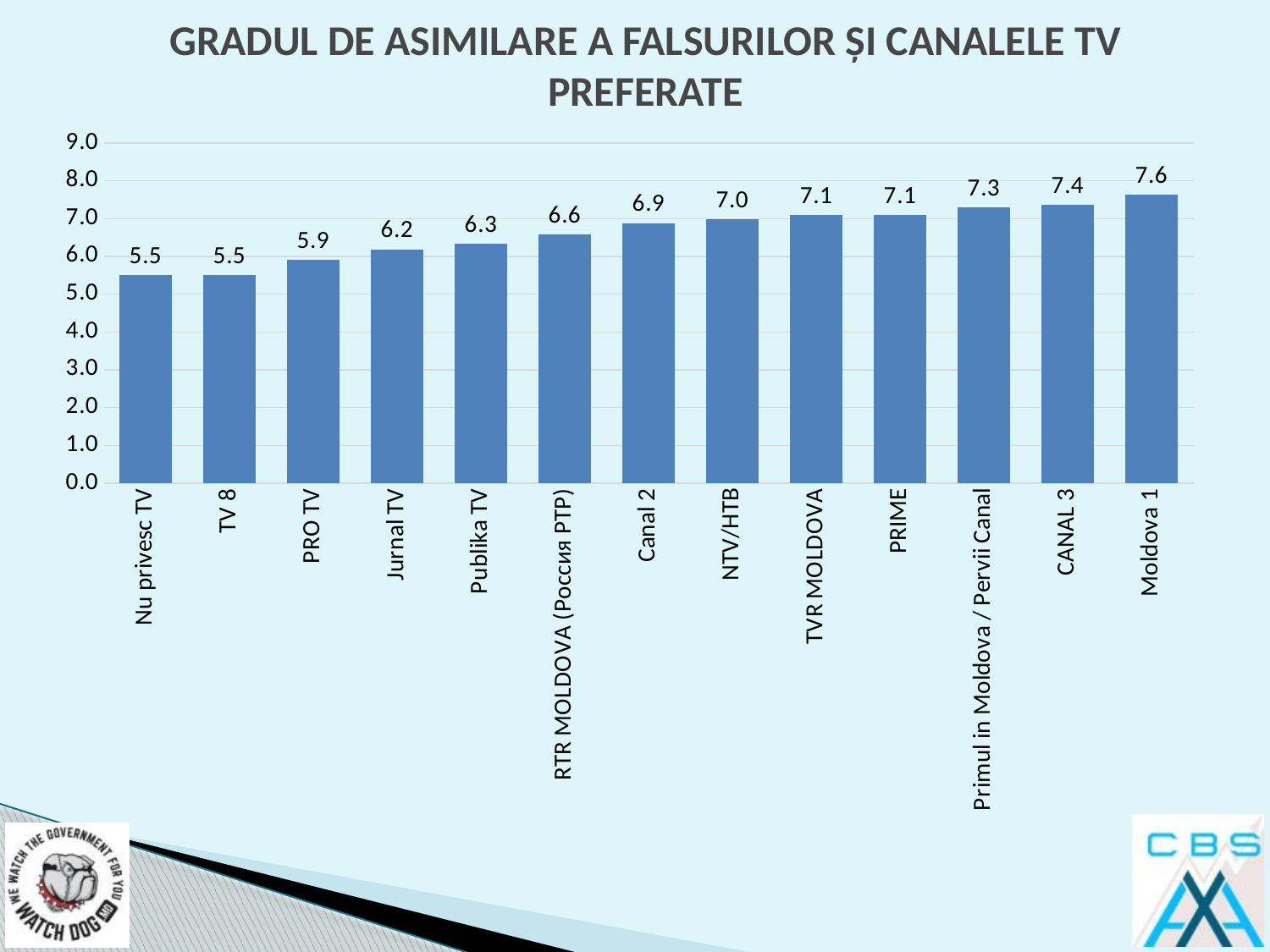
Which category has the highest value? Moldova 1 What is the value for Moldova 1? 7.6 What is the difference between the values for Moldova 1 and PRO TV? 1.7 Which is larger, the value for Canal 2 or the value for Publika TV? Canal 2 What is the lowest value shown on the chart? 5.5 Is the value for CANAL 3 greater or less than 7.0? greater What is the title of the chart? GRADUL DE ASIMILARE A FALSURILOR ȘI CANALELE TV PREFERATE What is the value for Jurnal TV? 6.2 What kind of chart is shown on the slide? bar chart What is the value for RTR MOLDOVA (Россия РТР)? 6.6 How many categories are shown on the x axis? 13 Do the values rise or fall from left to right along the x axis? rise